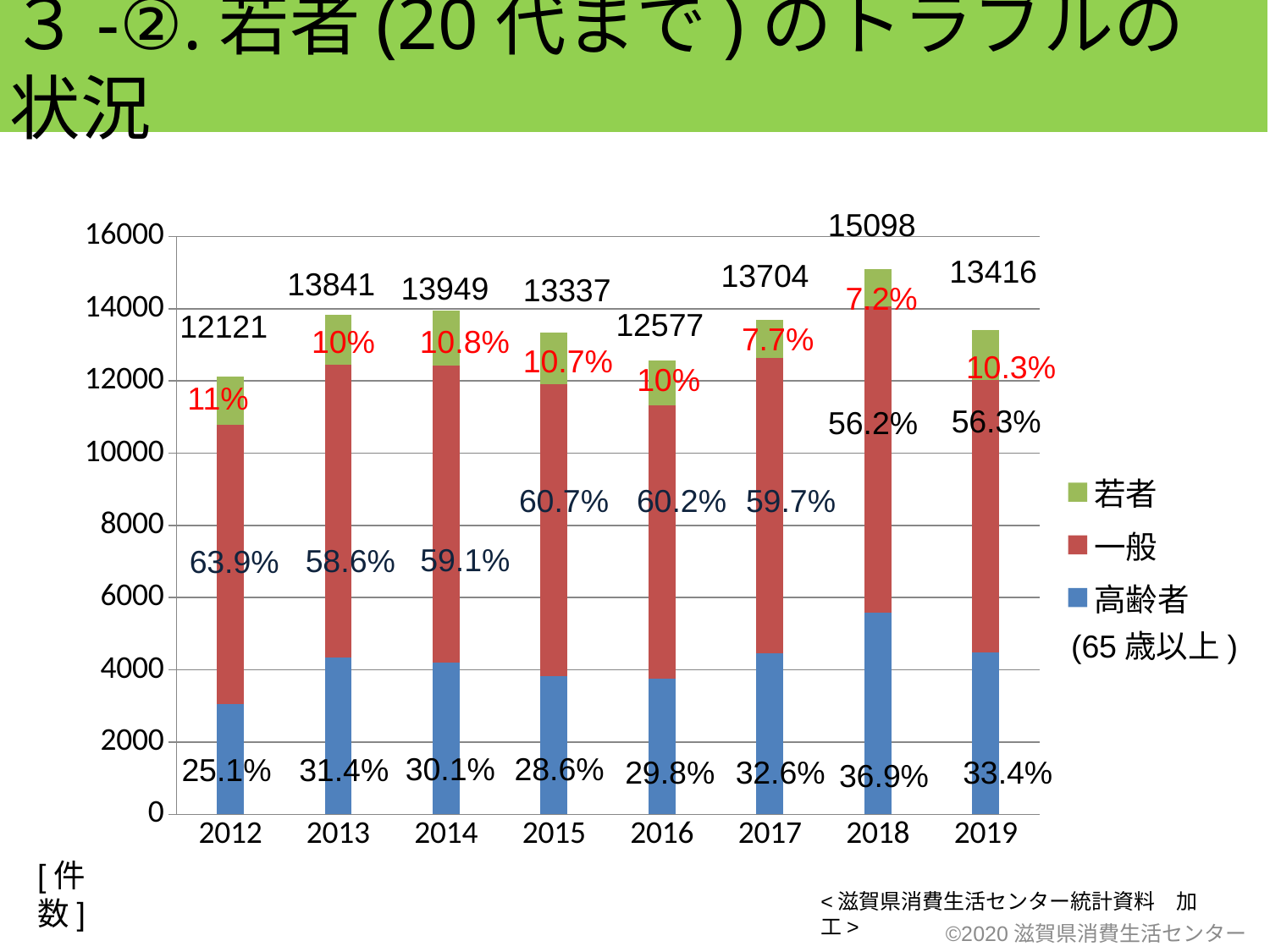
What kind of chart is shown on the slide? stacked bar chart What is the total number of cases shown above the bar for 2018? 15098 Which year has the lowest percentage for 若者? 2018 Which year has the larger total, 2013 or 2014? 2014 Is the 高齢者 (65歳以上) segment for 2018 greater or less than 4000? greater Which year has the lowest total number of cases? 2012 What percentage is shown for 若者 in 2017? 7.7% Which year has the highest total number of cases? 2018 What percentage is shown for 高齢者 (65歳以上) in 2012? 25.1% What is the difference between the total for 2018 and the total for 2019? 1682 How many years are shown on the x axis? 8 How many series does the legend list? 3